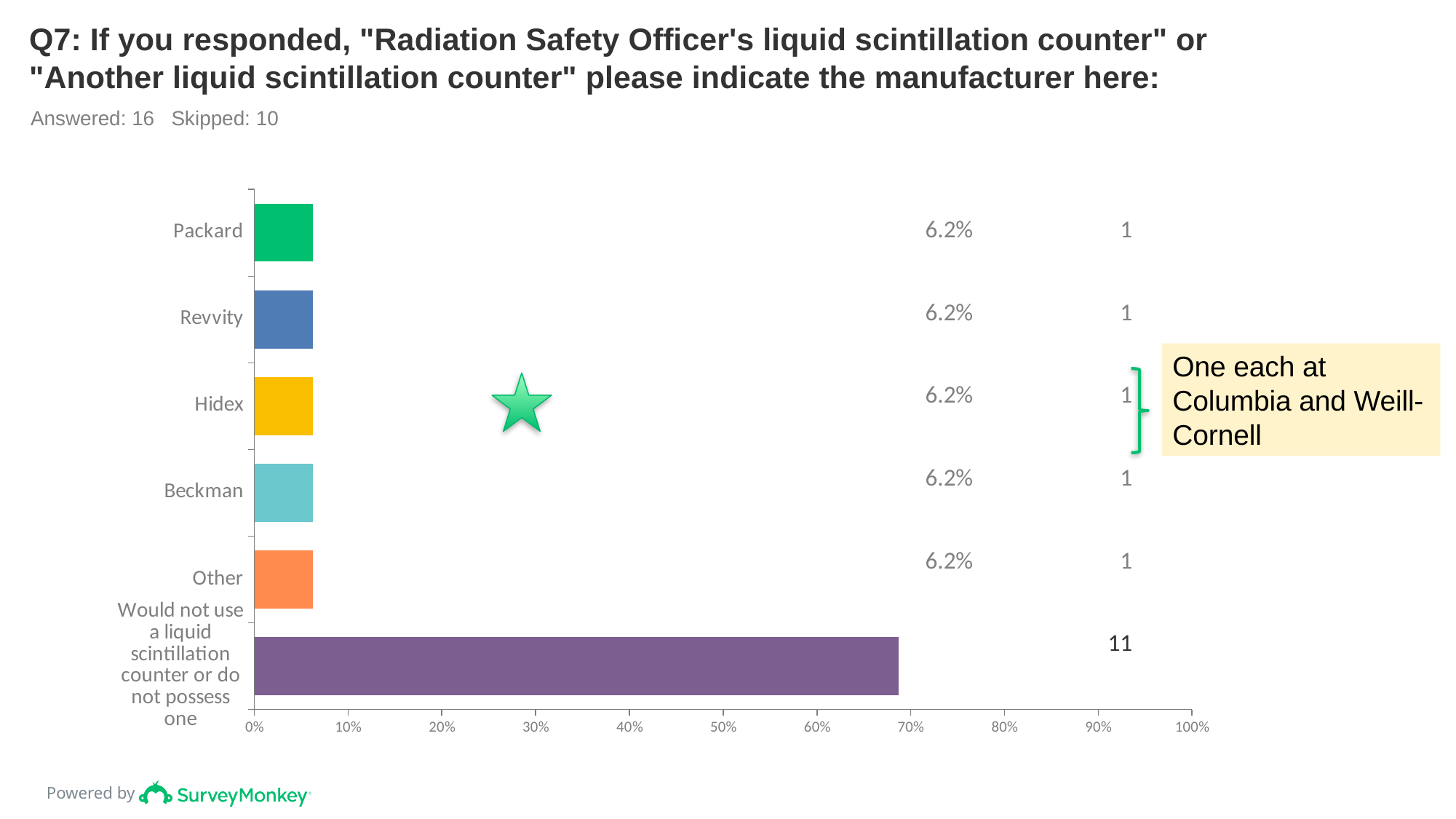
Is the value for "Would not use a liquid scintillation counter or do not possess one" greater or less than 70%? less What percentage is shown for Packard? 6.2% How many responses are shown for the category "Would not use a liquid scintillation counter or do not possess one"? 11 Is the value for Beckman greater or less than 10%? less Which is larger, the value for Revvity or the value for "Would not use a liquid scintillation counter or do not possess one"? Would not use a liquid scintillation counter or do not possess one How many responses are shown for Hidex? 1 Which category has the highest value? Would not use a liquid scintillation counter or do not possess one What is the difference in response count between "Would not use a liquid scintillation counter or do not possess one" and Other? 10 How many respondents answered this question according to the slide? 16 How many categories are shown in the chart? 6 What kind of chart is shown on the slide? bar chart Is the value for "Would not use a liquid scintillation counter or do not possess one" greater or less than 60%? greater